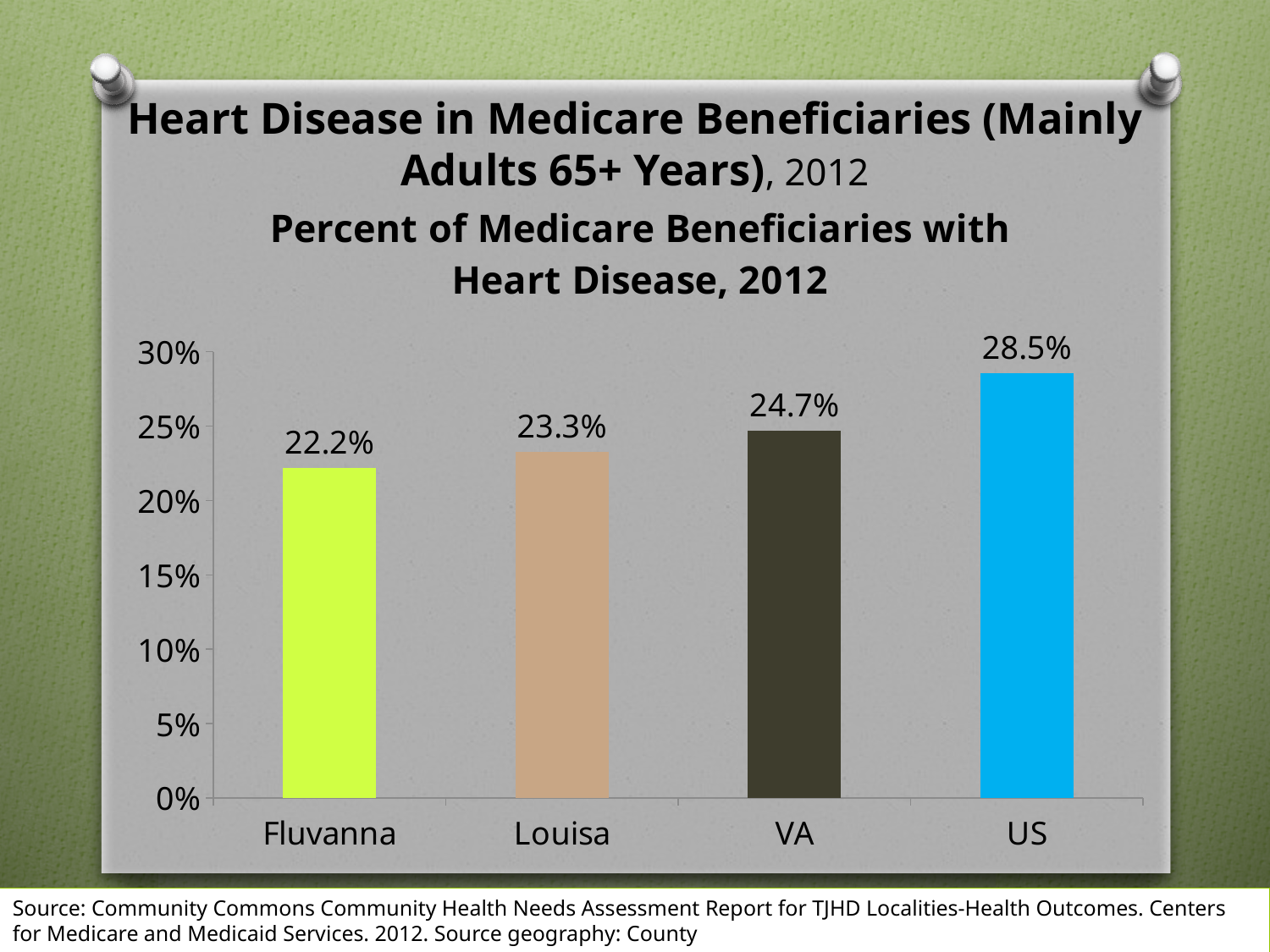
What is the percent of Medicare beneficiaries with heart disease for VA? 24.7% Is the value for VA greater or less than 25%? less What is the percent of Medicare beneficiaries with heart disease in Fluvanna? 22.2% What is the percent of Medicare beneficiaries with heart disease in Louisa? 23.3% How many categories are shown on the x axis of the chart? 4 Which category has the lowest percent of Medicare beneficiaries with heart disease? Fluvanna Do the values rise or fall moving from Fluvanna to US along the x axis? Rise What type of chart is shown on the slide? Bar chart What is the difference in percentage points between the US and Fluvanna values? 6.3 Which has a higher percent of Medicare beneficiaries with heart disease, Louisa or VA? VA Which category has the highest percent of Medicare beneficiaries with heart disease? US What is the percent of Medicare beneficiaries with heart disease for the US? 28.5%